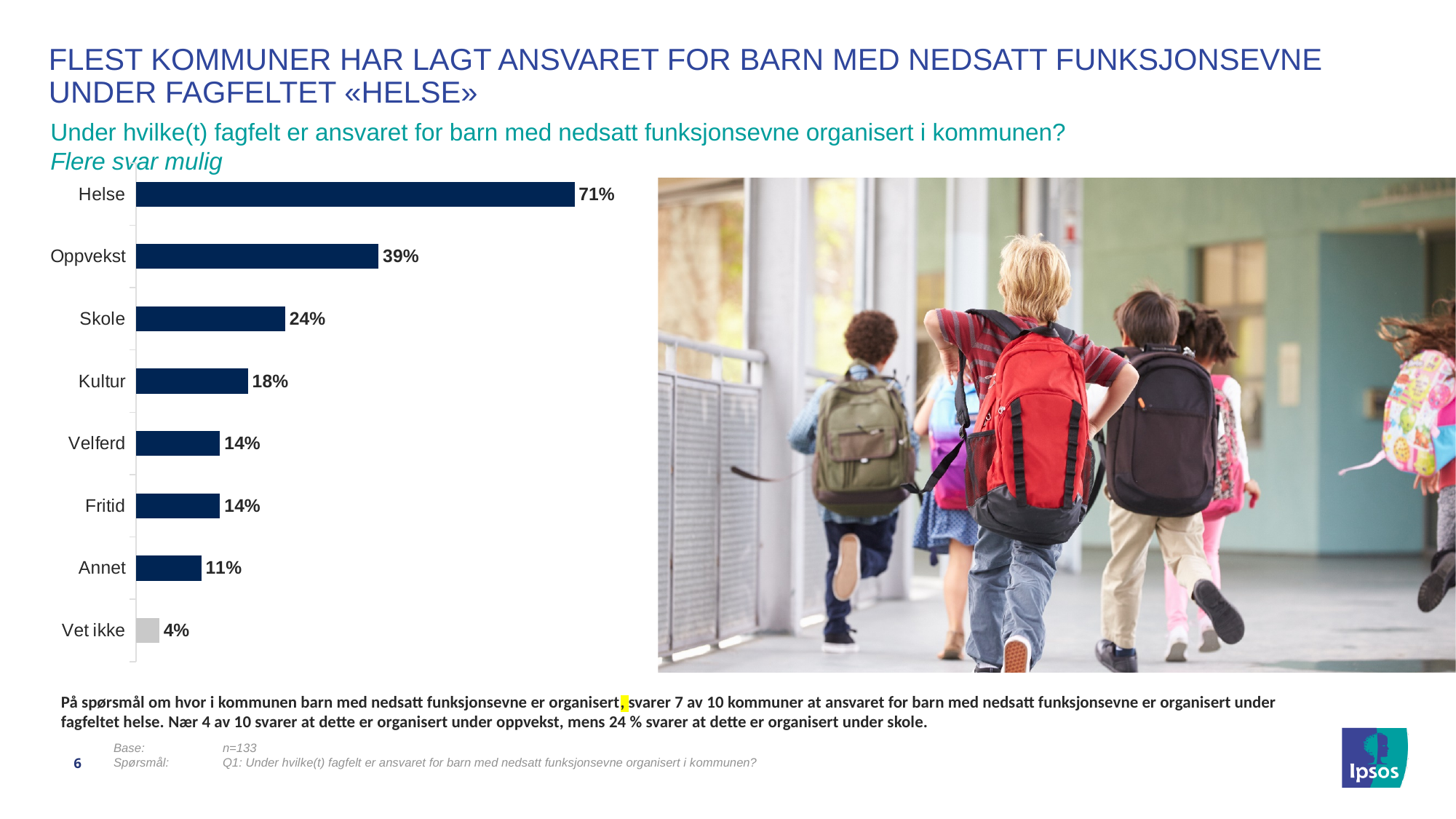
Which category's bar is shown in grey rather than dark blue? Vet ikke What is the value for Oppvekst? 39% Which category has the highest value? Helse Which category has the lowest value? Vet ikke Which is larger, the value for Skole or the value for Kultur? Skole What is the difference between the values for Helse and Oppvekst? 32% What is the value for Kultur? 18% What is the difference between the values for Skole and Annet? 13% What kind of chart is shown on the slide? Bar chart How many categories are shown in the chart? 8 What is the value for Helse? 71% What is the value for Vet ikke? 4%